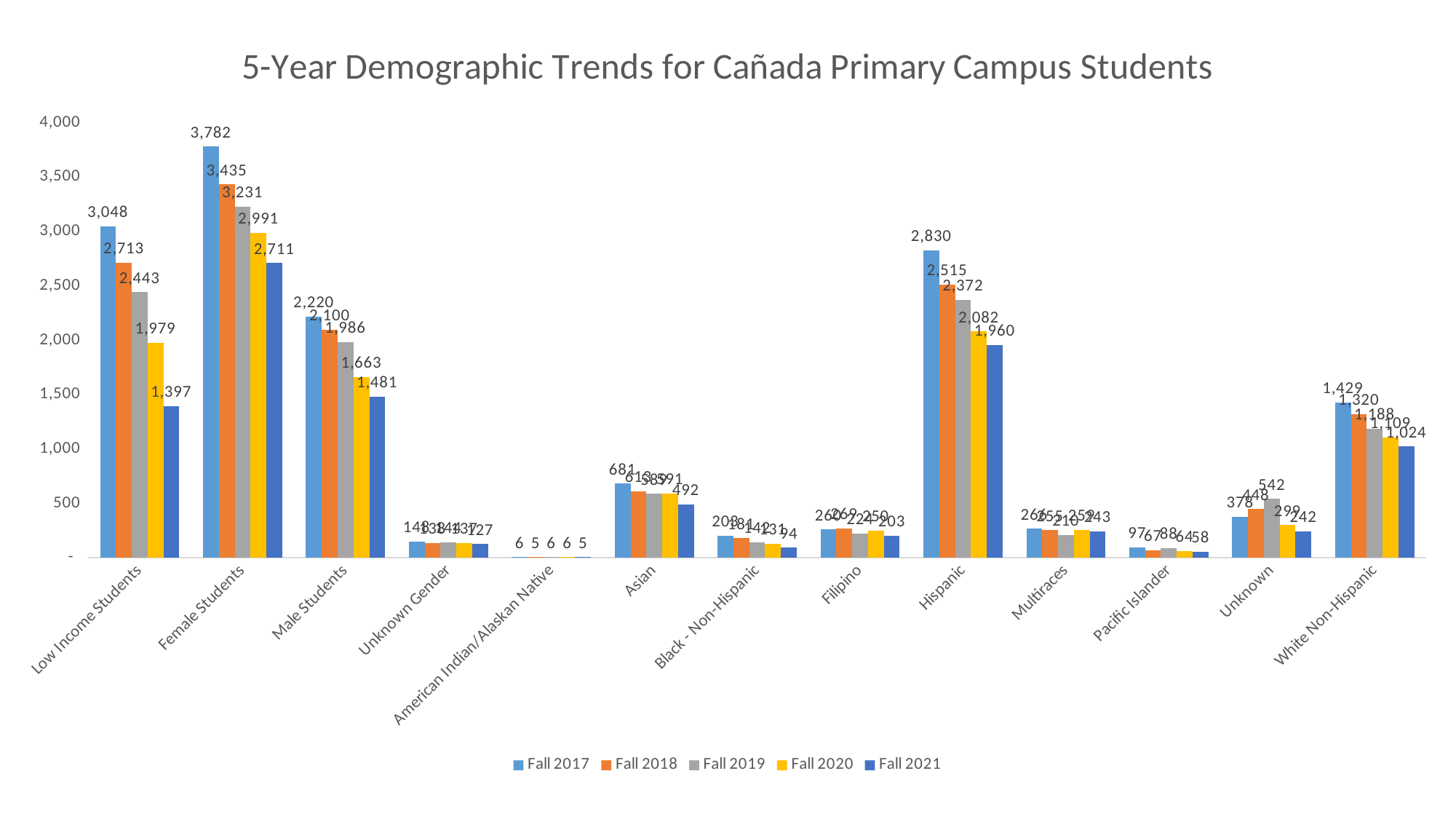
What is the value for Low Income Students in Fall 2020? 1,979 Is the Fall 2019 value for Unknown greater or less than 500? greater Which category has the highest value in Fall 2017? Female Students What is the value for White Non-Hispanic students in Fall 2019? 1,188 Do the values for Female Students rise or fall from Fall 2017 to Fall 2021? fall How many categories are shown on the x axis? 13 What is the value for Hispanic students in Fall 2021? 1,960 What is the difference between the Fall 2017 and Fall 2021 values for Low Income Students? 1,651 What is the value for Female Students in Fall 2017? 3,782 How many series does the legend list? 5 Which is larger: the Fall 2018 value for Male Students or the Fall 2018 value for Hispanic students? Hispanic students Which category has the lowest value in Fall 2021? American Indian/Alaskan Native